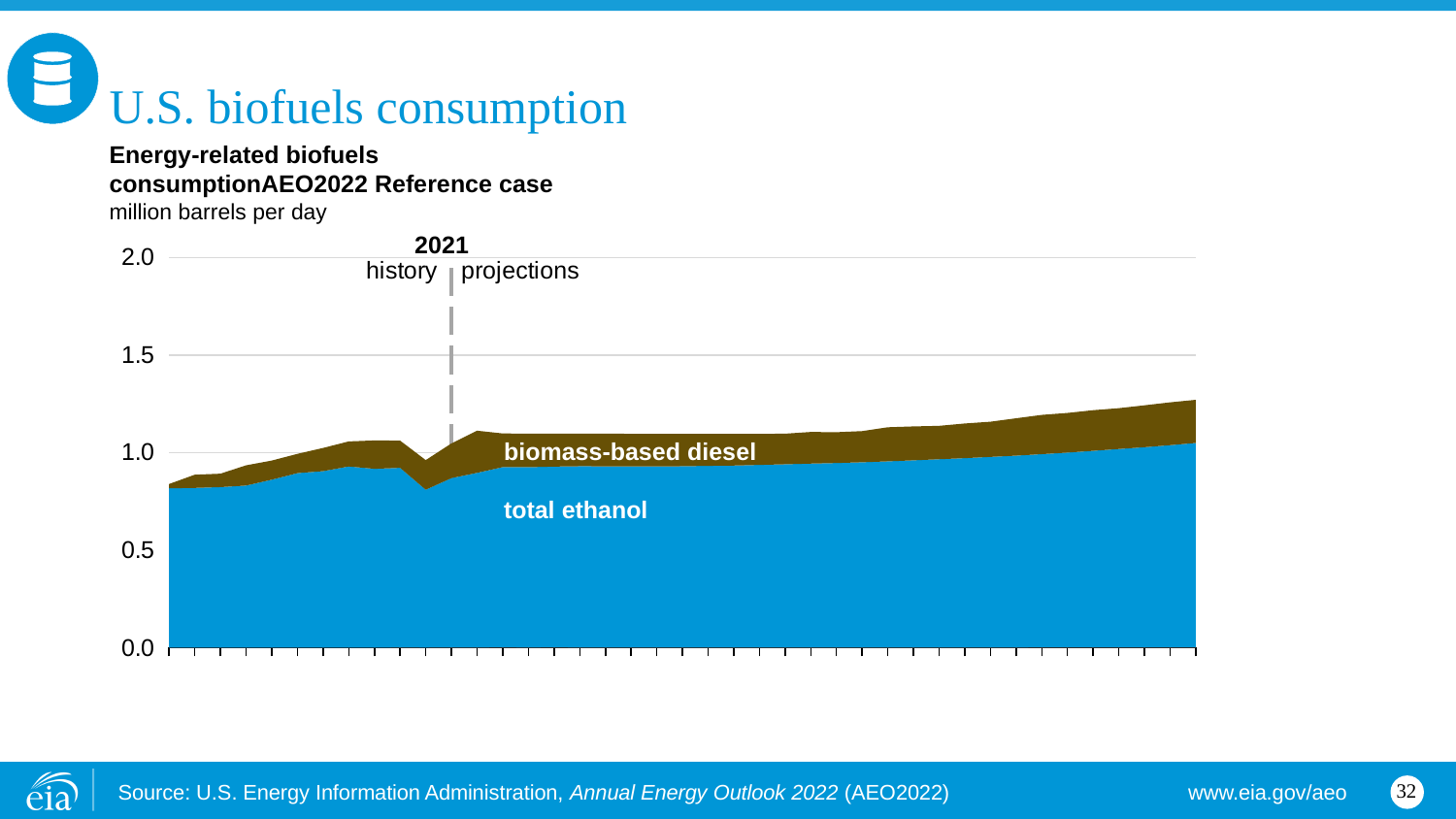
How many series are plotted in the chart? 2 Is total ethanol consumption at the start of the history period greater or less than 1.0 million barrels per day? less Is the total biofuels consumption at the right end of the projection period greater or less than 1.0 million barrels per day? greater What unit is used on the chart's y-axis? million barrels per day Which series occupies the larger area of the chart, total ethanol or biomass-based diesel? total ethanol What kind of chart is shown on the slide? stacked area chart What is the highest value shown on the y-axis? 2.0 Is the total biofuels consumption at the right end of the projection period greater or less than 1.5 million barrels per day? less Does total biofuels consumption rise or fall over the projection period? rise What year separates history from projections in the chart? 2021